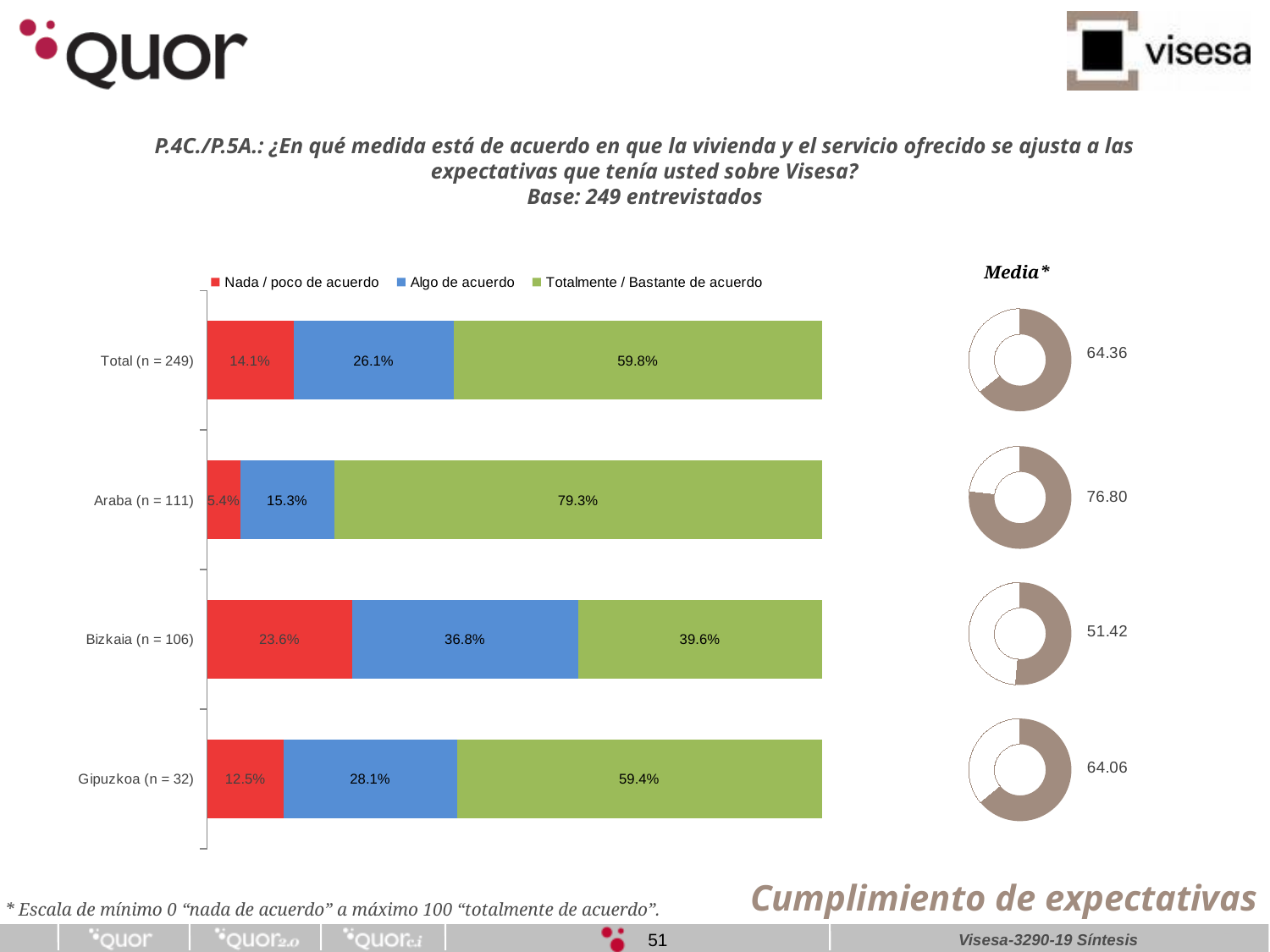
In the stacked bar chart, which category has the lowest "Nada / poco de acuerdo" share? Araba (n = 111) In the stacked bar chart, what is the "Nada / poco de acuerdo" value for Gipuzkoa (n = 32)? 12.5% In the stacked bar chart, what is the difference between the "Algo de acuerdo" values for Bizkaia (n = 106) and Araba (n = 111)? 21.5% In the stacked bar chart, which is larger: the "Totalmente / Bastante de acuerdo" value for Total (n = 249) or for Bizkaia (n = 106)? Total (n = 249) In the "Media*" donut charts, what is the mean value for Bizkaia (n = 106)? 51.42 What type of chart is used to show the agreement levels by region? Stacked bar chart In the stacked bar chart, what is the "Totalmente / Bastante de acuerdo" value for Araba (n = 111)? 79.3% How many series does the legend of the stacked bar chart list? 3 In the stacked bar chart, what percentage of Bizkaia (n = 106) respondents answered "Algo de acuerdo"? 36.8% How many categories are shown in the stacked bar chart? 4 In the stacked bar chart, which category has the highest "Totalmente / Bastante de acuerdo" share? Araba (n = 111) In the "Media*" donut charts, which category has the highest mean value? Araba (n = 111)